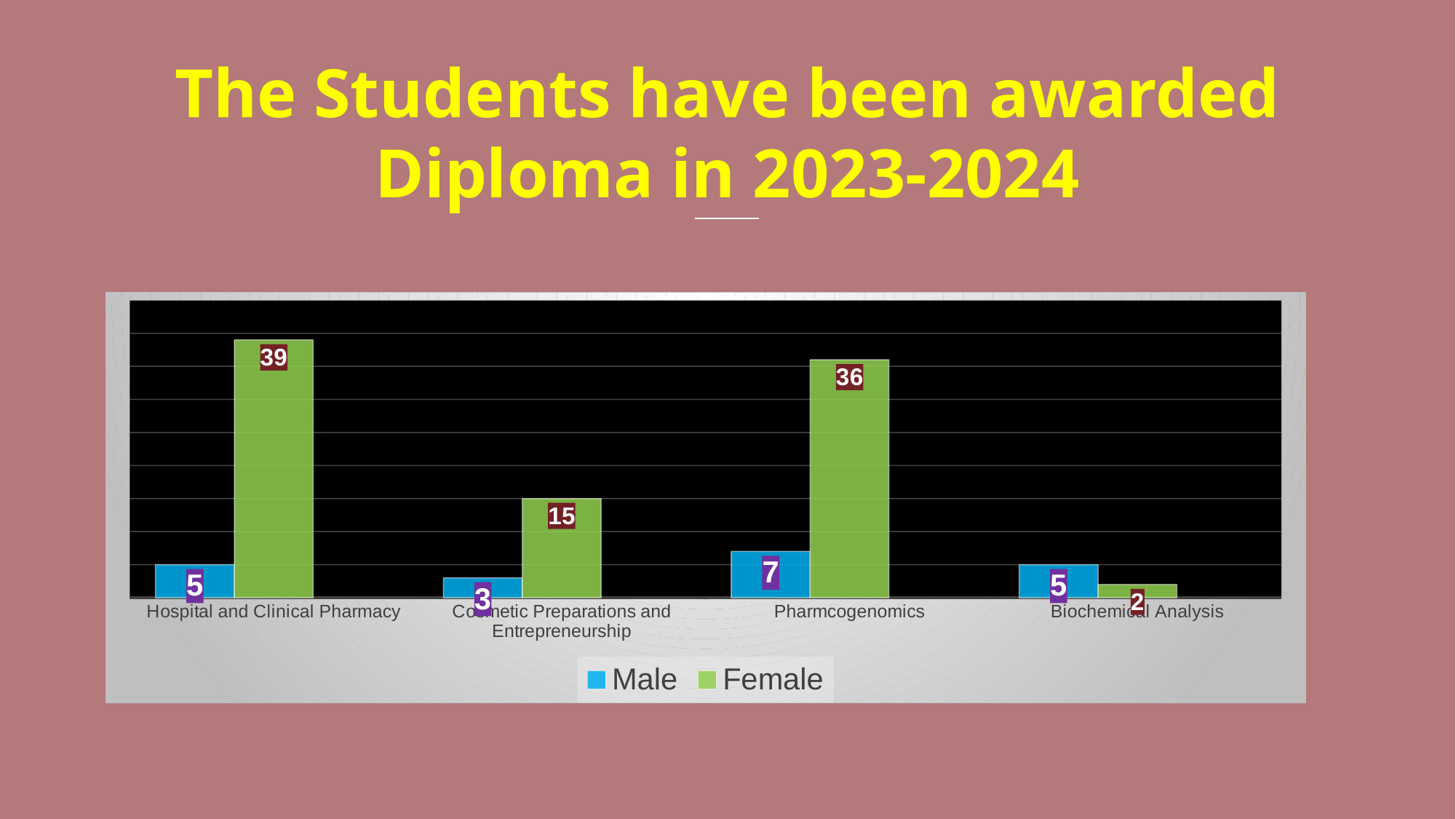
What is the Female value for Cosmetic Preparations and Entrepreneurship? 15 How many Female students were awarded a Diploma in Hospital and Clinical Pharmacy? 39 Which category has the lowest Male value? Cosmetic Preparations and Entrepreneurship What colour represents the Female series in the chart? Green Which category has the highest Female value? Hospital and Clinical Pharmacy What is the difference between the Female and Male values for Pharmcogenomics? 29 What kind of chart is shown on the slide? Bar chart How many Male students were awarded a Diploma in Pharmcogenomics? 7 How many categories are shown on the x axis? 4 Which is larger for Biochemical Analysis, the Male value or the Female value? Male What is the Male value for Biochemical Analysis? 5 How many series does the legend list? 2